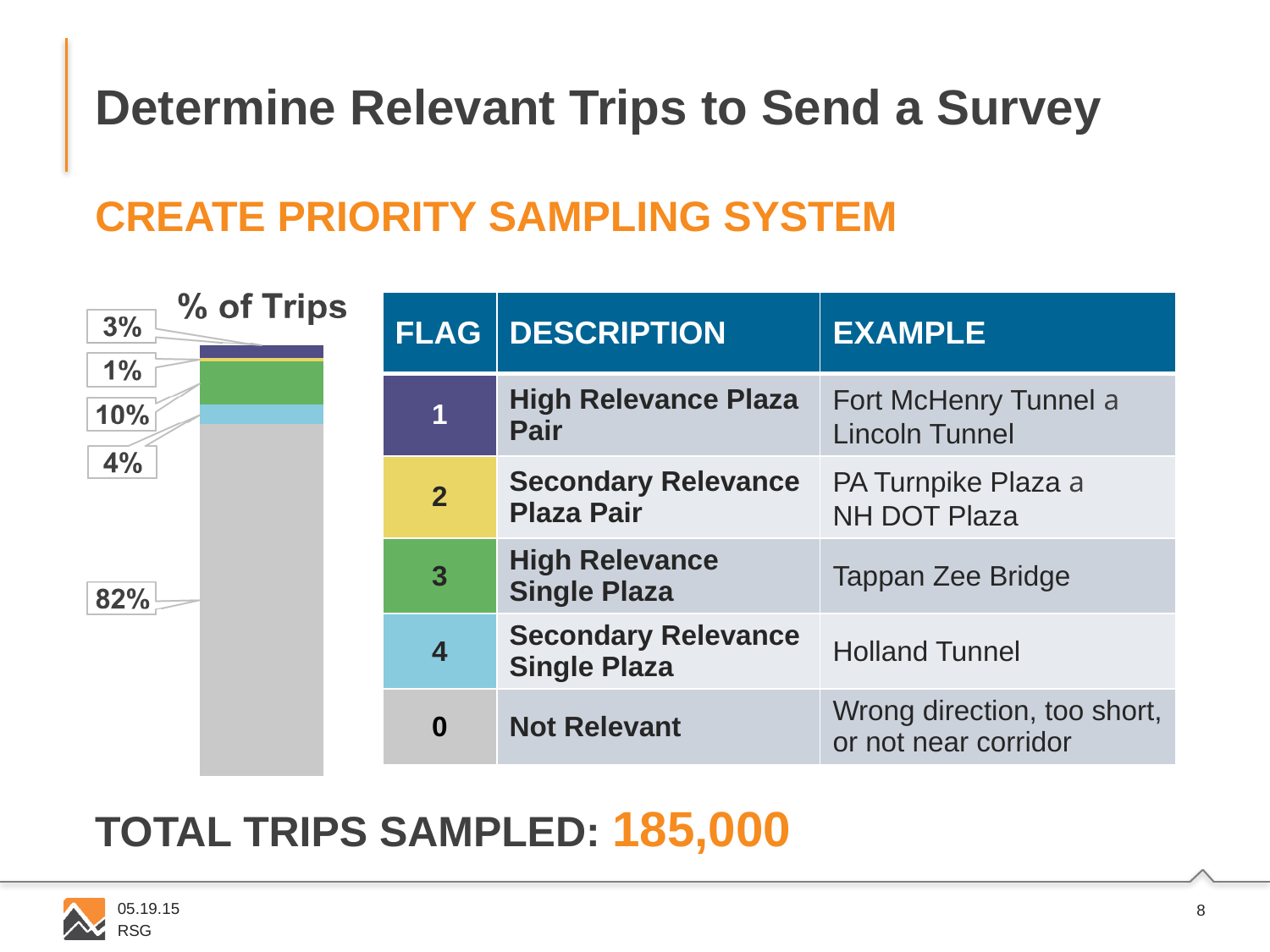
Which is larger, the purple segment or the yellow segment? purple segment (3%) What is the largest percentage labelled on the bar? 82% What kind of chart is shown on the slide? stacked bar chart What percentage of trips does the largest (gray) segment of the bar represent? 82% What percentage of trips does the green segment of the bar represent? 10% What is the difference between the green segment (10%) and the light blue segment (4%)? 6% What is the total of all the labelled segments in the stacked bar? 100% What percentage of trips does the light blue segment of the bar represent? 4% What percentage of trips does the purple segment at the top of the bar represent? 3% What is the smallest percentage labelled on the bar? 1% What is the title of the chart on the slide? % of Trips How many segments are labelled on the stacked bar? 5